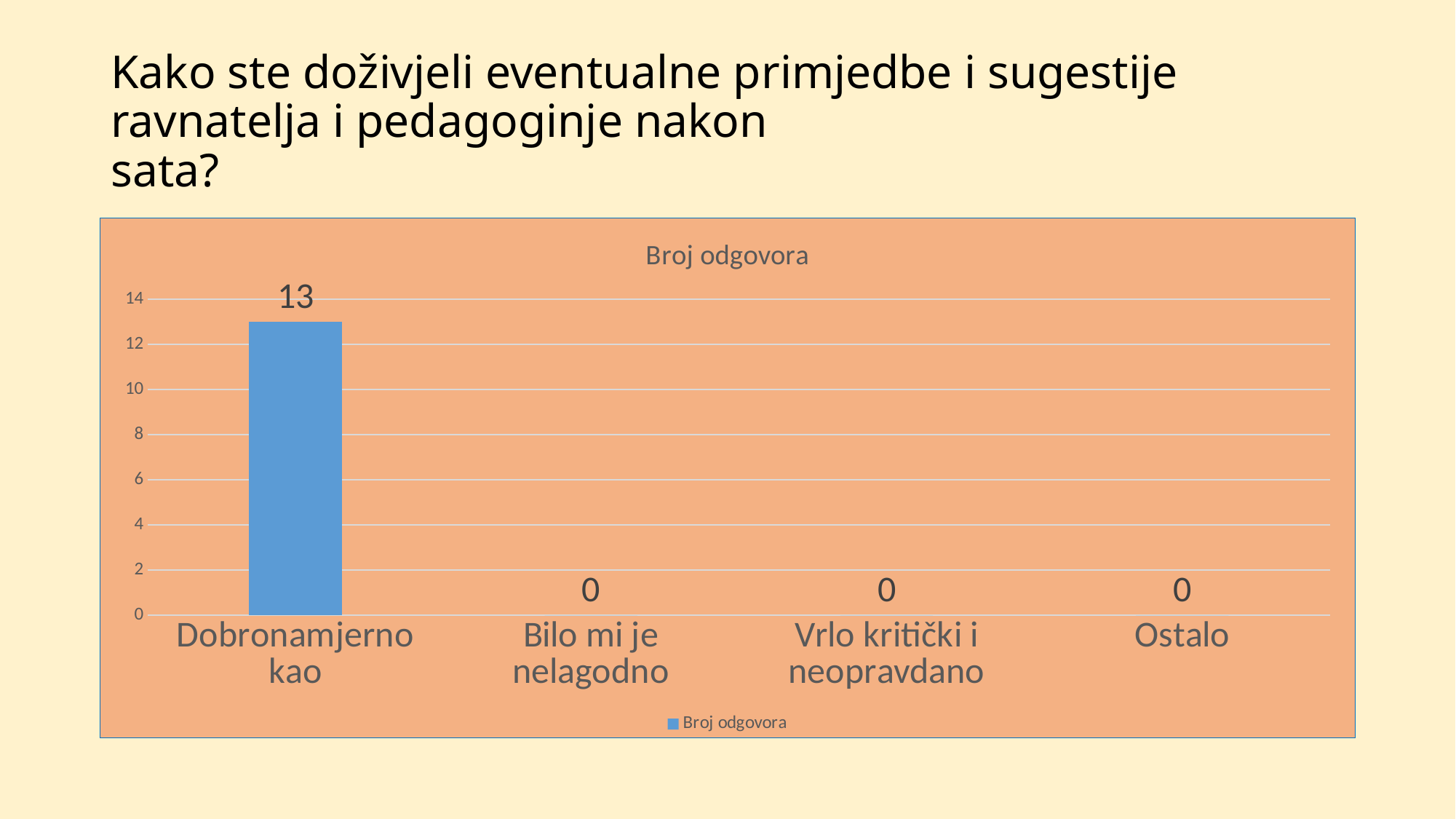
What is the difference between the values for "Dobronamjerno kao" and "Ostalo"? 13 What kind of chart is shown? bar chart What is the title of the chart? Broj odgovora Which is larger, the value for "Dobronamjerno kao" or the value for "Bilo mi je nelagodno"? Dobronamjerno kao Which category has the highest value? Dobronamjerno kao What is the value for "Dobronamjerno kao"? 13 What is the value for "Vrlo kritički i neopravdano"? 0 How many categories are shown on the x axis? 4 How many series does the legend list? 1 Is the value for "Dobronamjerno kao" greater or less than 10? greater What is the value for "Ostalo"? 0 What is the value for "Bilo mi je nelagodno"? 0